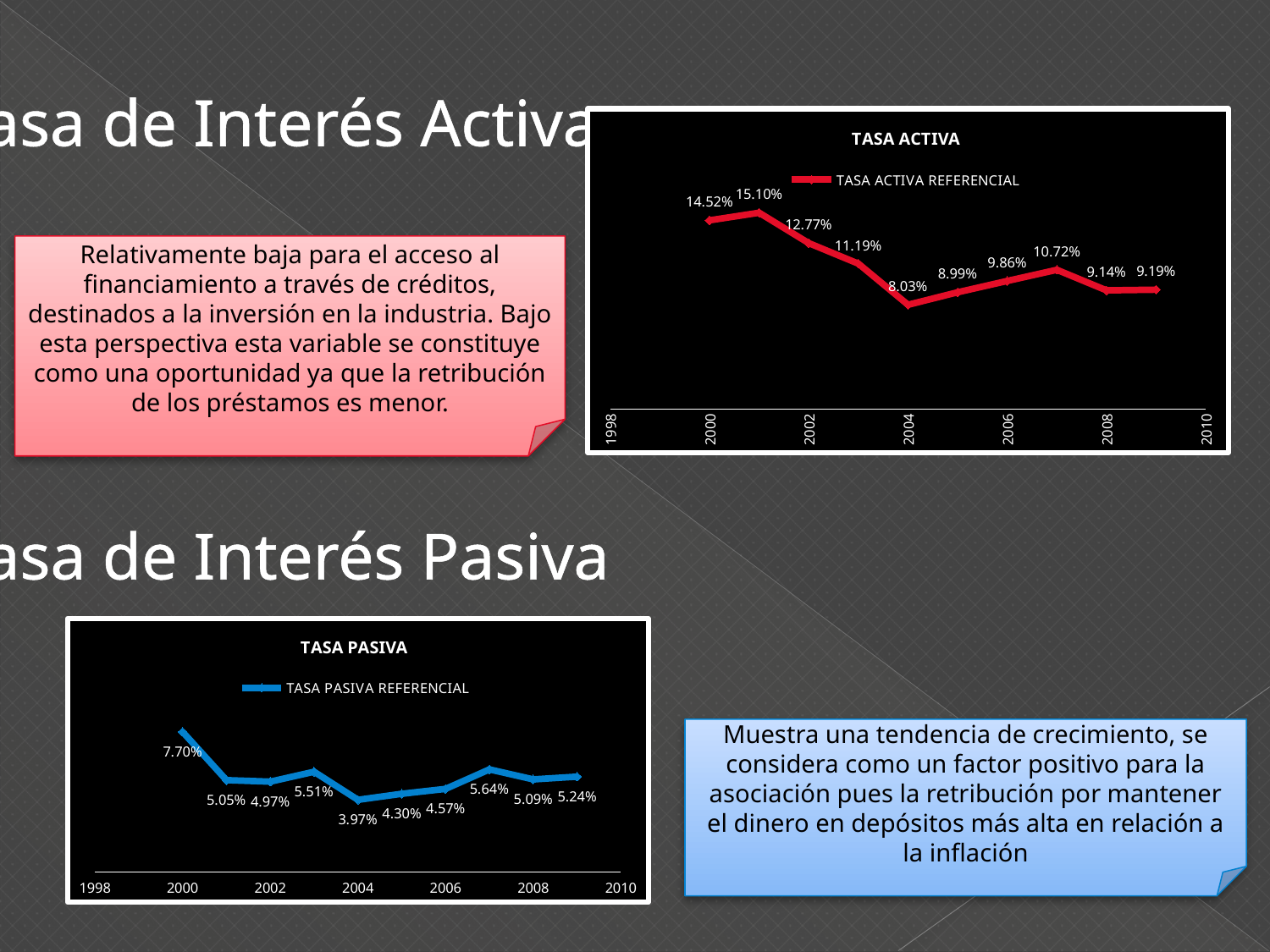
In the TASA PASIVA chart, what is the highest value shown? 7.70% In the TASA ACTIVA chart, what is the highest value shown? 15.10% In the TASA PASIVA chart, what is the lowest value shown? 3.97% In the TASA ACTIVA chart, what is the value for 2004? 8.03% What is the legend entry in the TASA PASIVA chart? TASA PASIVA REFERENCIAL In the TASA ACTIVA chart, what is the value for 2000? 14.52% In the TASA PASIVA chart, which is larger, the value for 2006 (4.57%) or the value for 2008 (5.09%)? 2008 (5.09%) In the TASA ACTIVA chart, what is the lowest value shown? 8.03% In the TASA ACTIVA chart, what is the difference between the highest value (15.10%) and the lowest value (8.03%)? 7.07% In the TASA PASIVA chart, what is the value for 2004? 3.97% What type of chart is the TASA ACTIVA chart? line chart In the TASA ACTIVA chart, how many data points are plotted? 10